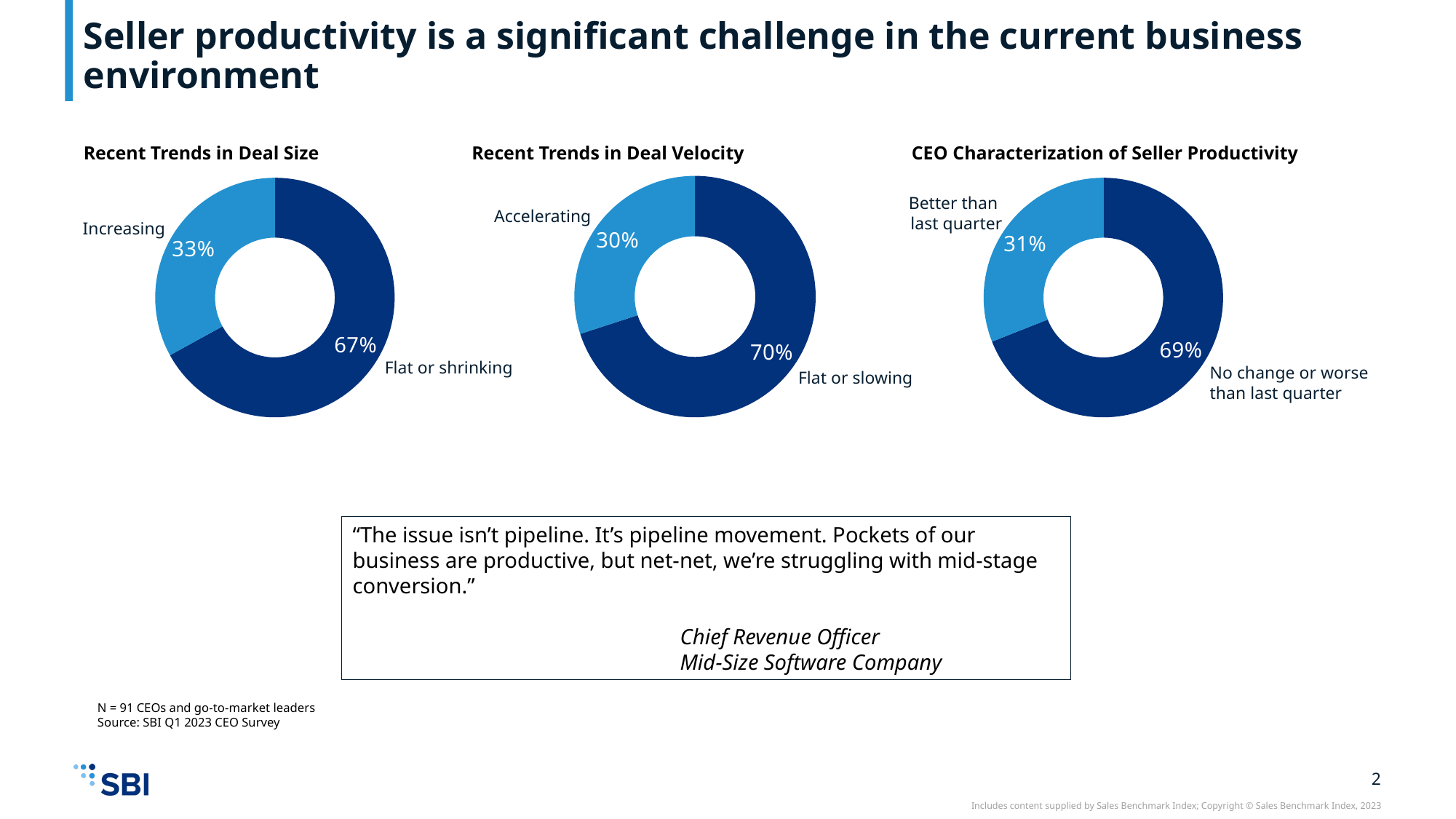
How many slices does the 'Recent Trends in Deal Velocity' chart have? 2 What type of chart is used for 'Recent Trends in Deal Size'? Doughnut chart In the 'Recent Trends in Deal Velocity' chart, which category has the smallest share? Accelerating In the 'Recent Trends in Deal Size' chart, what is the difference between the 'Flat or shrinking' and 'Increasing' shares? 34 percentage points In the 'Recent Trends in Deal Size' chart, what percentage is labelled 'Increasing'? 33% In the 'CEO Characterization of Seller Productivity' chart, which is larger: 'Better than last quarter' or 'No change or worse than last quarter'? No change or worse than last quarter In the 'CEO Characterization of Seller Productivity' chart, what percentage is labelled 'Better than last quarter'? 31% In the 'Recent Trends in Deal Velocity' chart, what percentage is labelled 'Accelerating'? 30% In the 'Recent Trends in Deal Size' chart, what percentage is labelled 'Flat or shrinking'? 67% In the 'CEO Characterization of Seller Productivity' chart, what percentage is labelled 'No change or worse than last quarter'? 69% In the 'Recent Trends in Deal Size' chart, which category has the largest share? Flat or shrinking In the 'Recent Trends in Deal Velocity' chart, what percentage is labelled 'Flat or slowing'? 70%